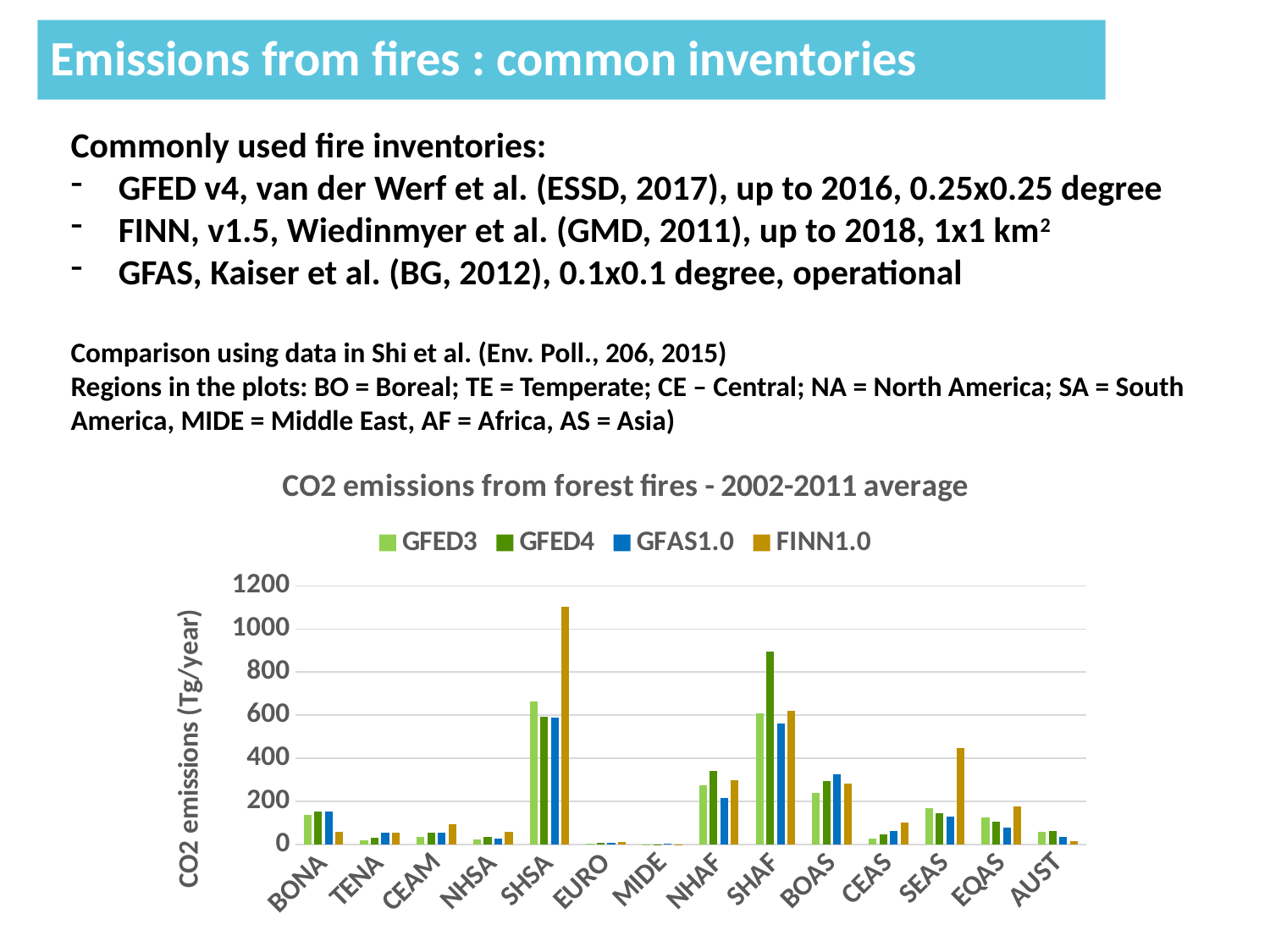
For SHSA, which is larger: the FINN1.0 value or the GFAS1.0 value? FINN1.0 What is the label of the y axis of the chart? CO2 emissions (Tg/year) How many series does the chart legend list? 4 For which region is the GFED4 value highest? SHAF For which region is the FINN1.0 value highest? SHSA For SHAF, which is larger: the GFED4 value or the GFED3 value? GFED4 What is the title of the chart? CO2 emissions from forest fires - 2002-2011 average How many regions (categories) are shown on the x axis of the chart? 14 Is the GFED4 value for SHAF greater or less than 800? greater What type of chart is shown on the slide? bar chart Is the FINN1.0 value for SHSA greater or less than 1000? greater Is the FINN1.0 value for SEAS greater or less than 400? greater